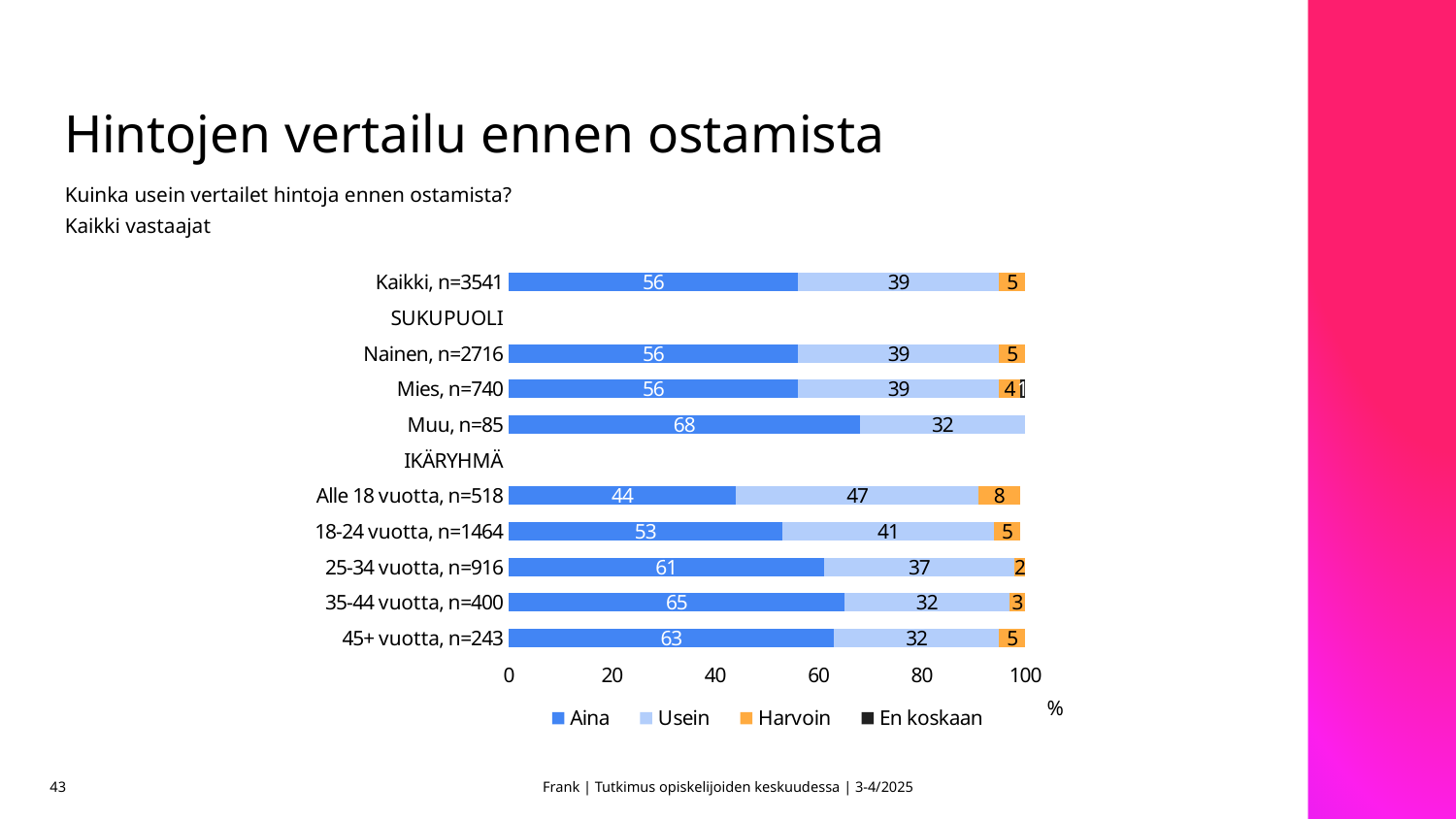
How many series does the legend list? 4 What is the 'Usein' value for 'Alle 18 vuotta, n=518'? 47 Which is larger: the 'Harvoin' value for 'Alle 18 vuotta, n=518' or for '45+ vuotta, n=243'? Alle 18 vuotta, n=518 Which category has the lowest 'Aina' value? Alle 18 vuotta, n=518 What is the difference between the 'Aina' values for '35-44 vuotta, n=400' and '18-24 vuotta, n=1464'? 12 What is the total of the stacked bar for '45+ vuotta, n=243'? 100 What is the 'Harvoin' value for '25-34 vuotta, n=916'? 2 What kind of chart is shown on the slide? Stacked bar chart Which category has the highest 'Aina' value? Muu, n=85 What is the 'Aina' value for 'Kaikki, n=3541'? 56 What is the 'Aina' value for 'Muu, n=85'? 68 What is the title of the slide containing the chart? Hintojen vertailu ennen ostamista